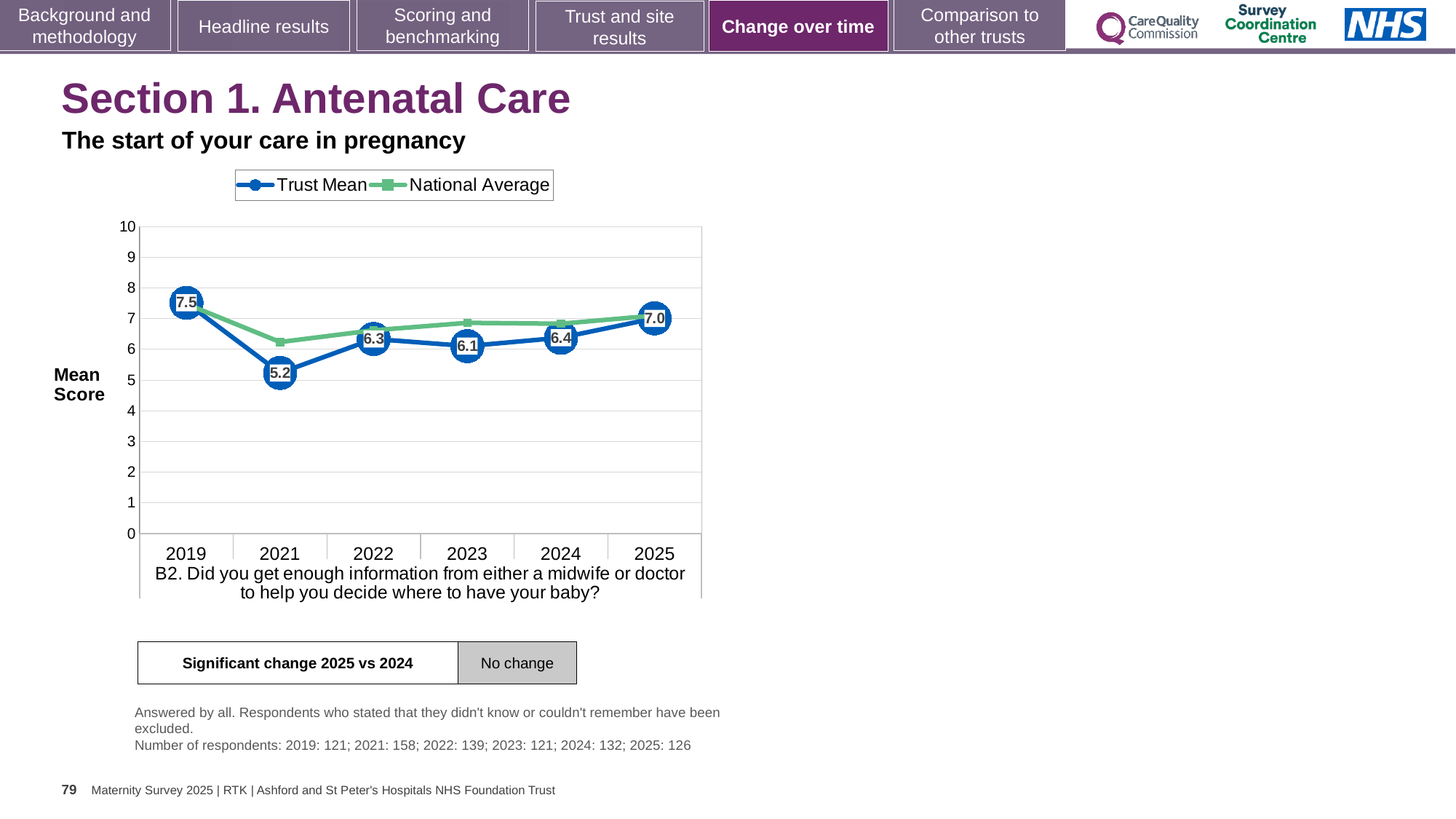
Which year has the highest Trust Mean? 2019 What is the Trust Mean for 2023? 6.1 What is the difference between the Trust Mean in 2019 and in 2021? 2.3 What kind of chart is shown on the slide? line chart Which year has the lowest Trust Mean? 2021 Which is larger, the Trust Mean for 2022 or for 2024? 2024 How many series does the legend list? 2 Is the National Average for 2021 greater or less than 7? less How many years are shown on the x axis? 6 What is the Trust Mean for 2019? 7.5 What is the Trust Mean for 2025? 7.0 What is the Trust Mean for 2021? 5.2